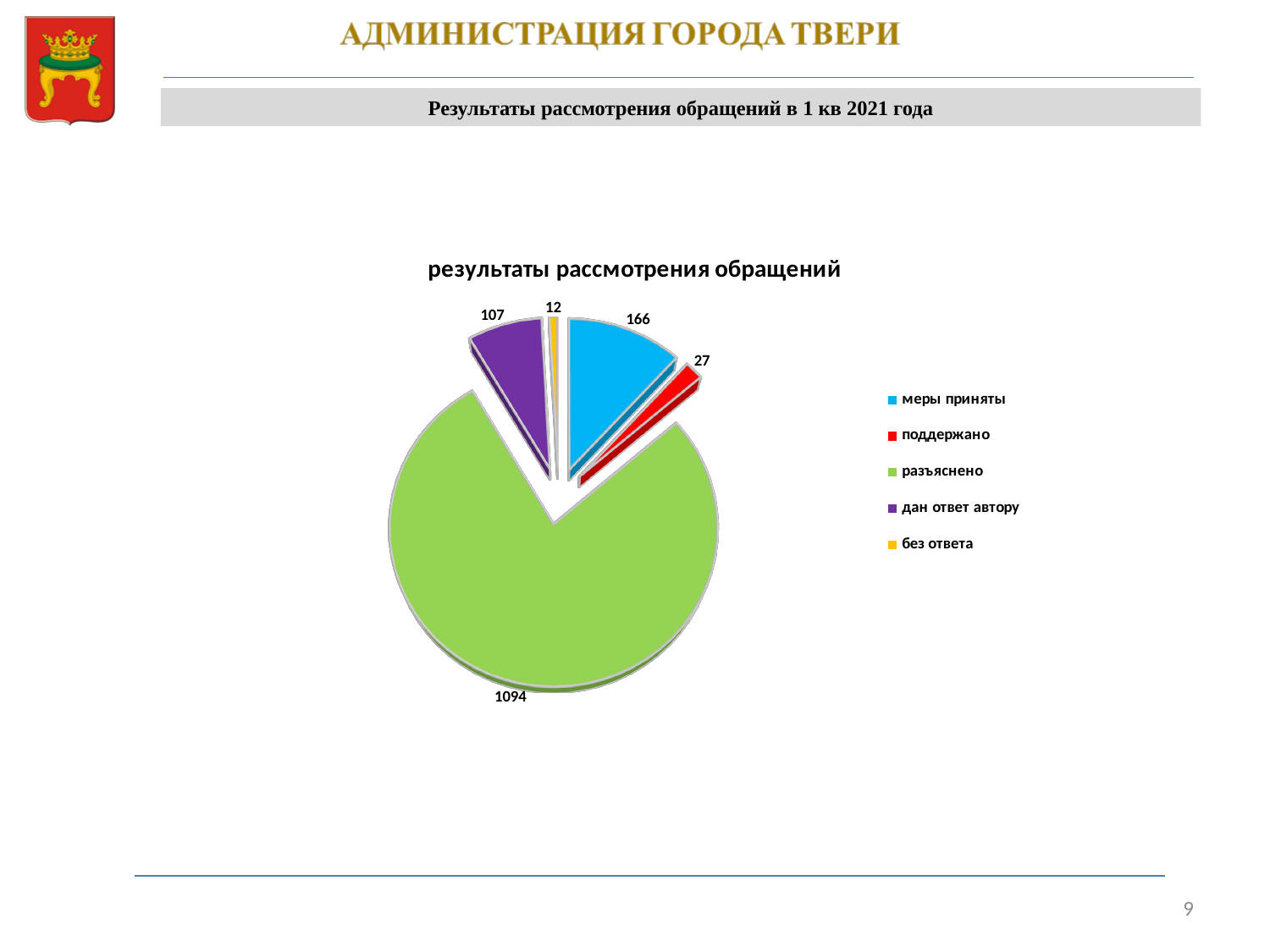
Which is larger, 'поддержано' or 'дан ответ автору'? дан ответ автору What is the title of the chart? результаты рассмотрения обращений What is the value for the 'дан ответ автору' slice? 107 What is the difference between the 'меры приняты' and 'дан ответ автору' values? 59 What is the value for the 'меры приняты' slice? 166 Which category has the smallest slice? без ответа What is the value for the 'разъяснено' slice? 1094 What kind of chart is shown on the slide? pie chart Which category has the largest slice? разъяснено What is the value for the 'без ответа' slice? 12 How many slices does the pie chart have? 5 What is the total of all slices in the pie chart? 1406